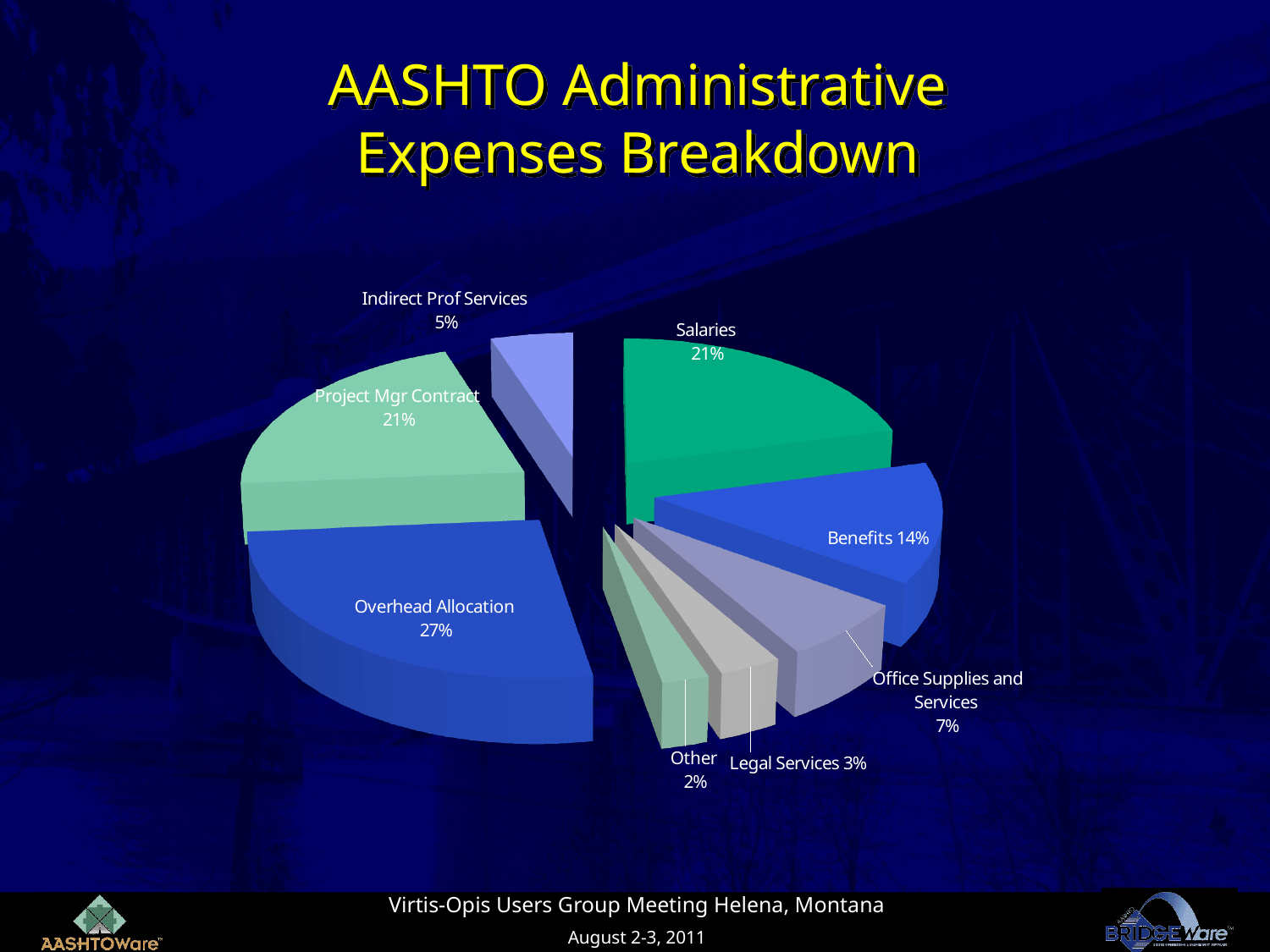
What percentage is shown for Legal Services? 3% What type of chart is shown on the slide? Pie chart What is the difference in percentage points between Overhead Allocation and Salaries? 6 What percentage of expenses goes to Benefits? 14% What is the title of the chart on the slide? AASHTO Administrative Expenses Breakdown How many slices does the pie chart have? 8 What is the combined share of Salaries and Project Mgr Contract? 42% Which category has the largest share of administrative expenses? Overhead Allocation What share of AASHTO administrative expenses is Overhead Allocation? 27% Which category has the smallest share of administrative expenses? Other What percentage is shown for Office Supplies and Services? 7% Which is larger, the share for Benefits or the share for Indirect Prof Services? Benefits